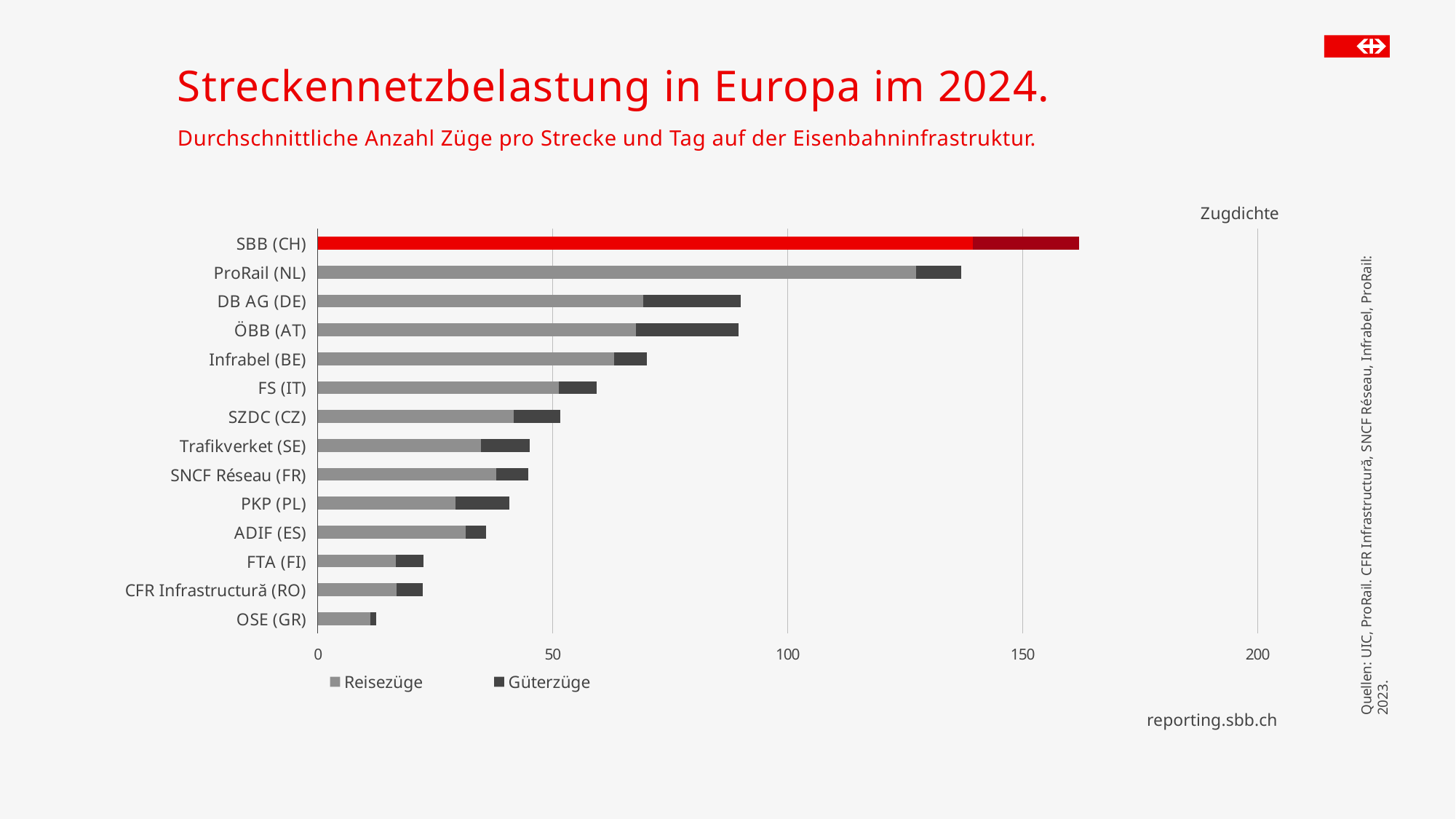
Which has the larger total train density, SBB (CH) or ProRail (NL)? SBB (CH) Is the total value for SBB (CH) greater or less than 150? greater Is the total value for DB AG (DE) greater or less than 100? less How many series does the legend list? 2 Which operator has the lowest total train density? OSE (GR) Is the total value for Infrabel (BE) greater or less than 50? greater How many infrastructure operators (categories) are shown in the chart? 14 Which operator has the highest total train density (Zugdichte)? SBB (CH) What kind of chart is shown on the slide? bar chart What are the two series named in the legend? Reisezüge and Güterzüge